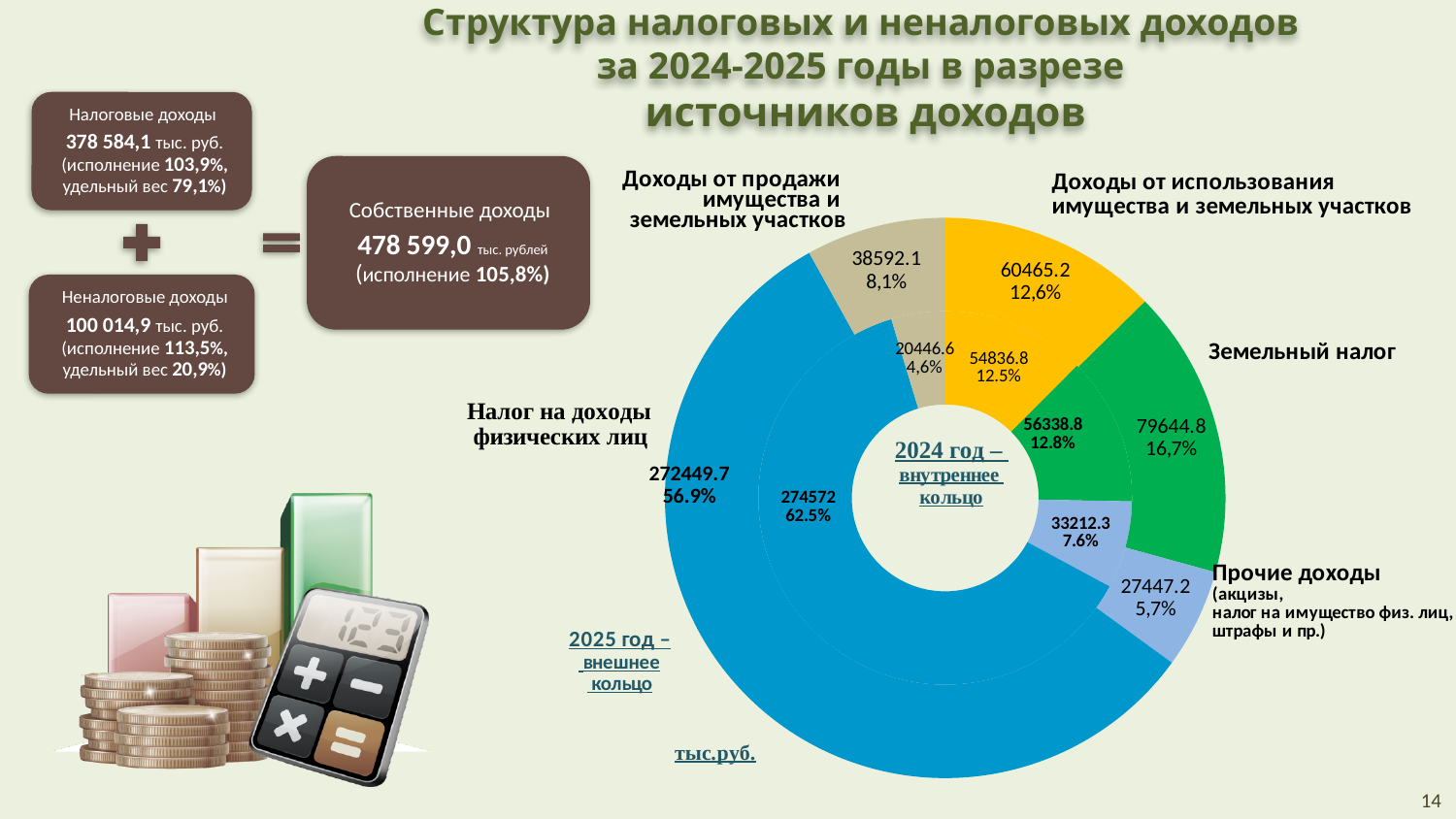
What is the value for Доходы от продажи имущества и земельных участков in the inner ring (2024 год)? 20446.6 What is the value for Налог на доходы физических лиц in the outer ring (2025 год)? 272449.7 Which year does the inner ring of the doughnut chart represent? 2024 год What is the difference between the Земельный налог values in the outer ring (2025 год) and the inner ring (2024 год)? 23306.0 Which category has the smallest share in the inner ring (2024 год)? Доходы от продажи имущества и земельных участков How many income source categories are shown in the doughnut chart? 5 What kind of chart is shown on the slide? Doughnut chart Which is larger: the value for Прочие доходы in the inner ring (2024 год) or in the outer ring (2025 год)? Inner ring (2024 год), 33212.3 What is the value for Земельный налог in the outer ring (2025 год)? 79644.8 What share does Налог на доходы физических лиц have in the inner ring (2024 год)? 62.5% Which category has the largest share in the outer ring (2025 год)? Налог на доходы физических лиц What share does Доходы от использования имущества и земельных участков have in the outer ring (2025 год)? 12,6%